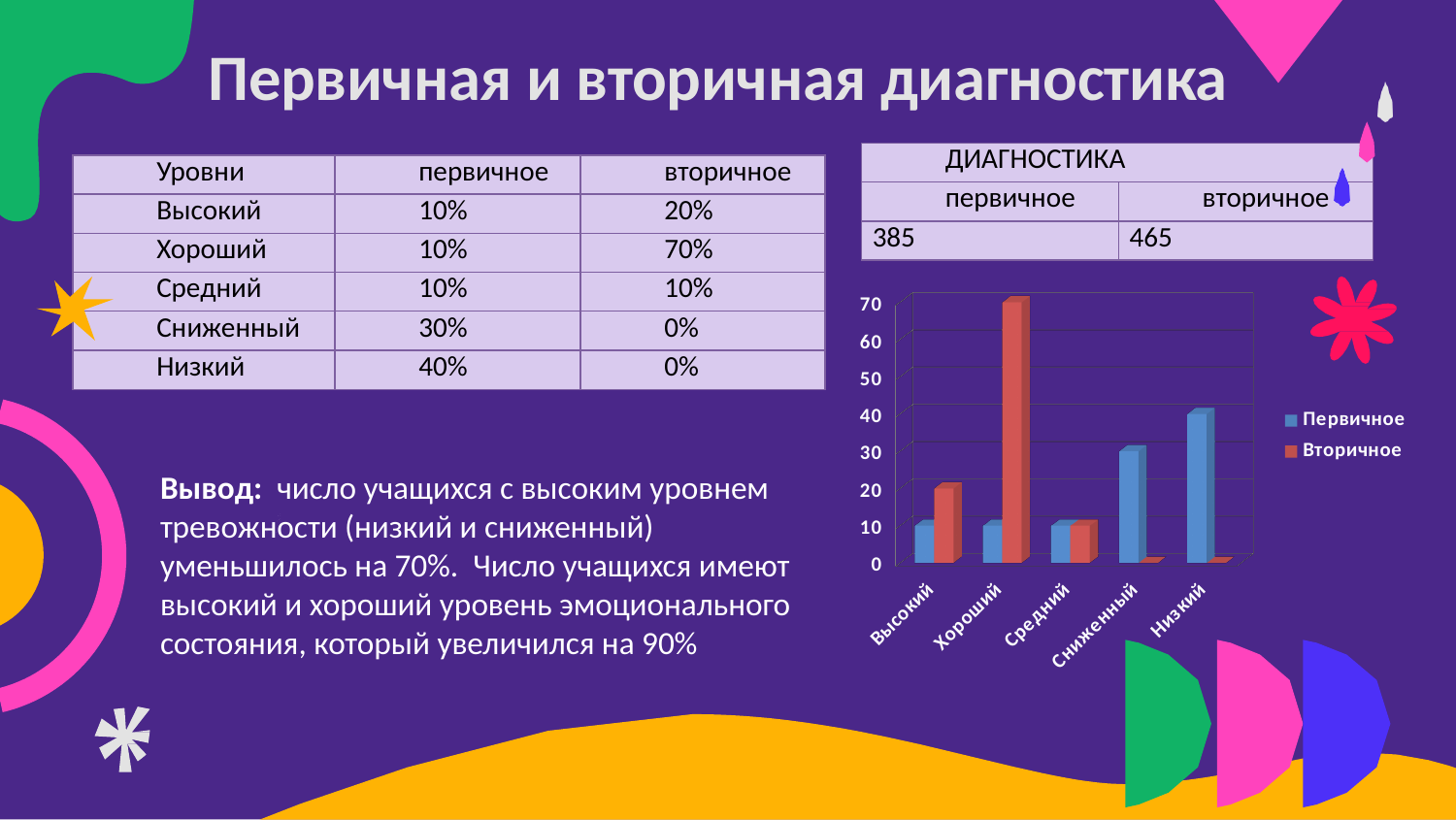
What are the two entries in the chart legend? Первичное and Вторичное How many categories are shown on the x axis of the chart? 5 For Высокий, which is larger in the chart: Первичное or Вторичное? Вторичное What is the value of Вторичное for Сниженный in the chart? 0 How many series does the chart legend list? 2 Which category has the highest Вторичное value in the chart? Хороший What is the value of Вторичное for Хороший in the chart? 70 In the chart, how much larger is Вторичное than Первичное for Хороший? 60 Which category has the highest Первичное value in the chart? Низкий Is the Первичное value for Сниженный in the chart greater or less than 20? greater What is the value of Первичное for Низкий in the chart? 40 What kind of chart is shown on the slide? bar chart